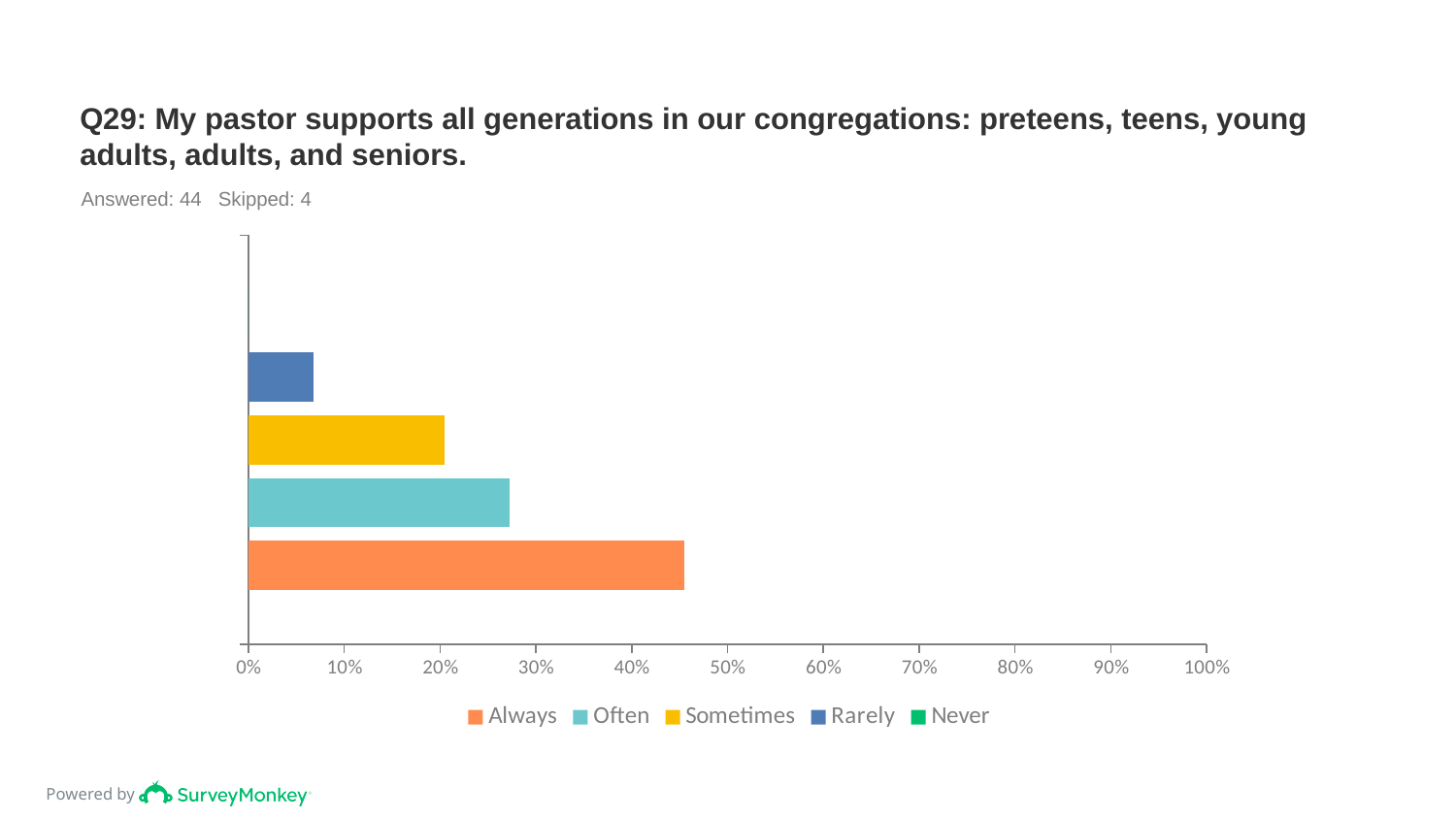
What colour is the bar for Always? orange Which is larger, the value for Always or the value for Often? Always What kind of chart is shown on the slide? bar chart Is the value for Sometimes greater or less than 30%? less What is the highest percentage shown on the x axis? 100% How many entries does the legend list? 5 Which response option has the longest bar? Always Which response option has the shortest bar (no visible bar at all)? Never Which is larger, the value for Often or the value for Sometimes? Often Is the value for Always greater or less than 40%? greater Is the value for Often greater or less than 20%? greater